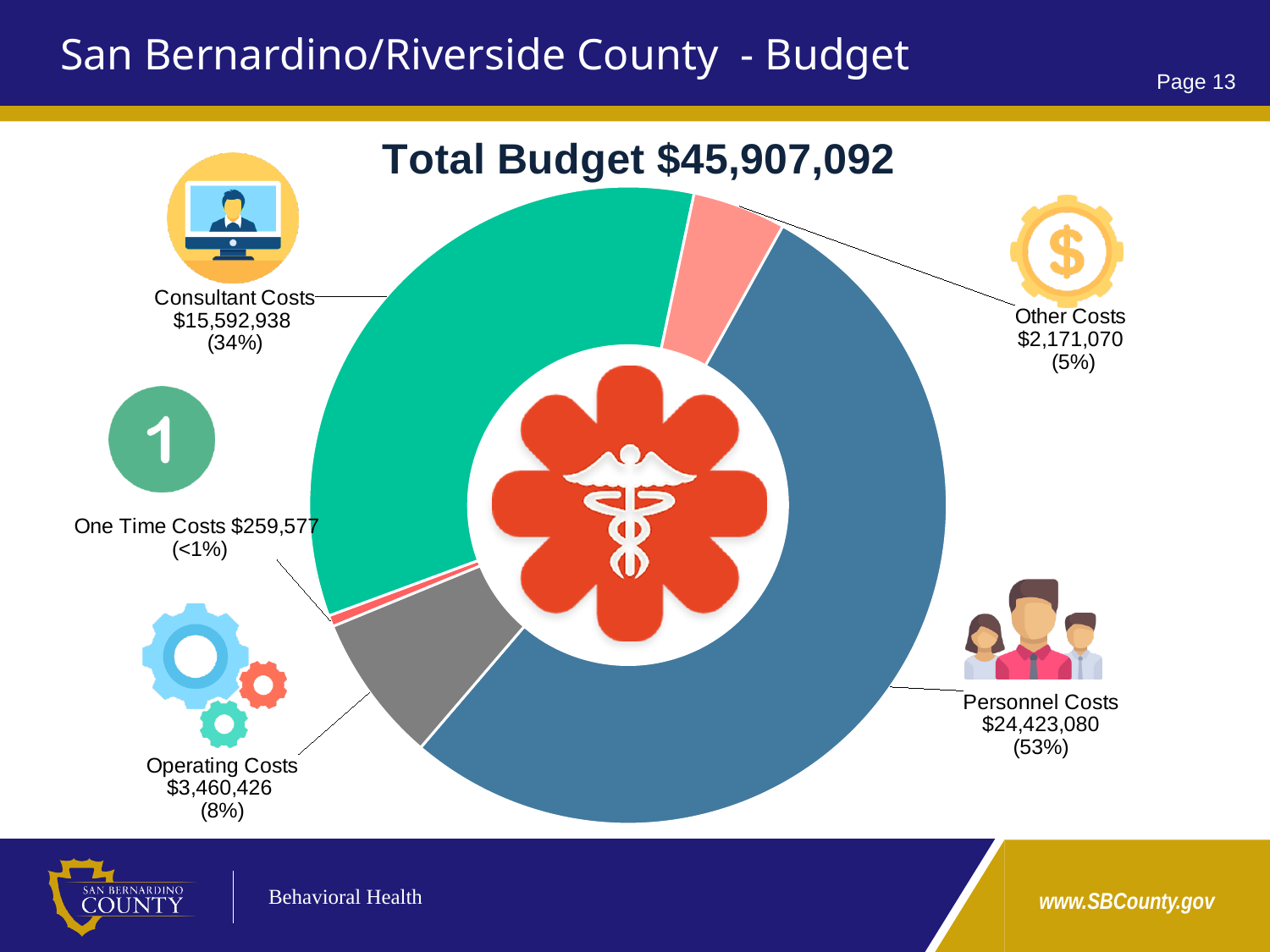
How many categories does the chart show? 5 Which category has the smallest share of the budget? One Time Costs What share of the budget is Consultant Costs? 34% Which category has the largest share of the budget? Personnel Costs What is the value for Operating Costs? $3,460,426 What is the value for Consultant Costs? $15,592,938 Which is larger, Operating Costs or Other Costs? Operating Costs What is the difference between Personnel Costs and Consultant Costs? $8,830,142 What is the value for Personnel Costs? $24,423,080 What is the value for One Time Costs? $259,577 What is the value for Other Costs? $2,171,070 What share of the budget is Operating Costs? 8%